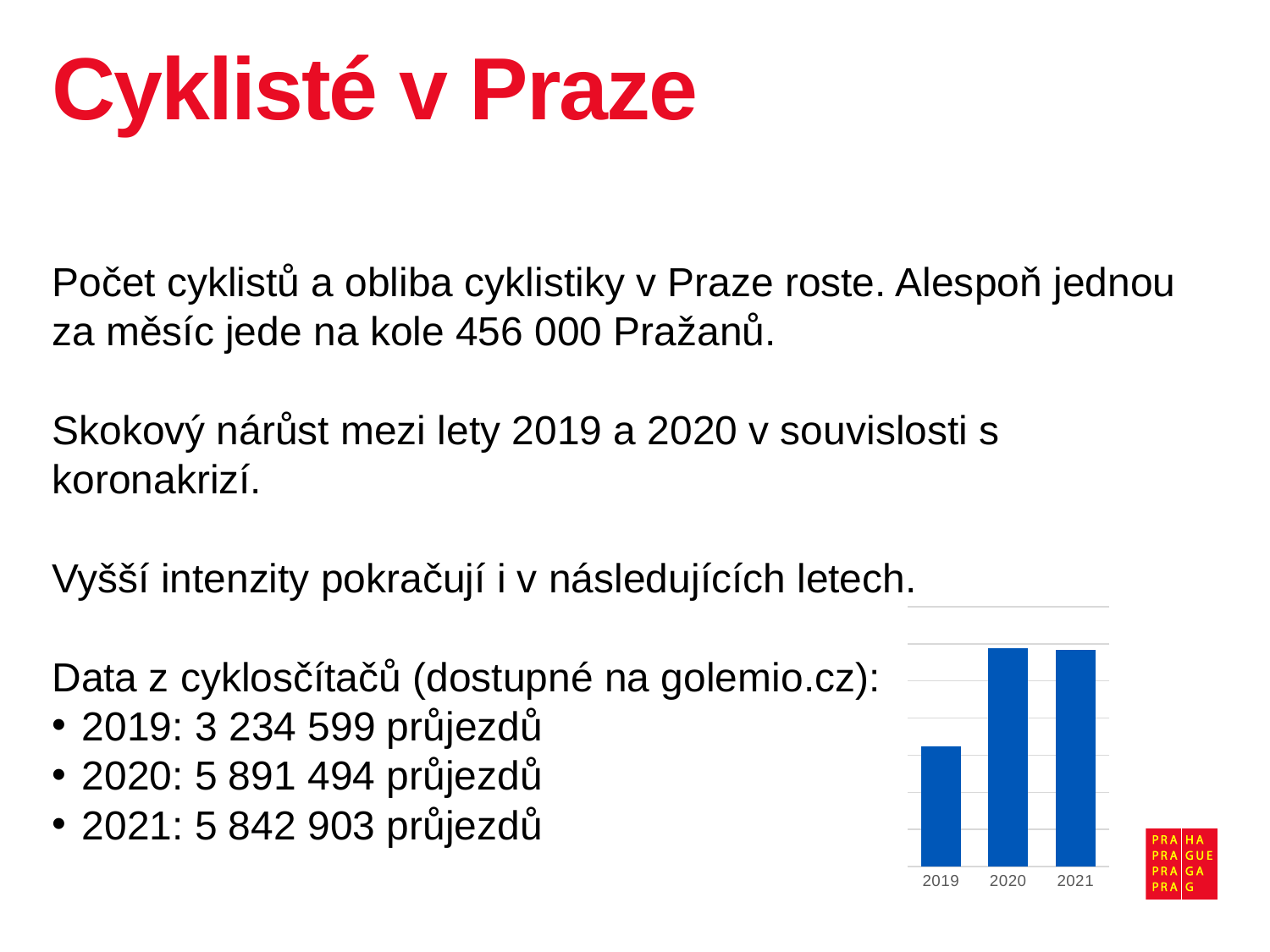
How many průjezdů were recorded in 2021? 5 842 903 What is the difference between the 2020 and 2019 values? 2 656 895 How many bars (years) does the chart show? 3 How many průjezdů were recorded in 2019? 3 234 599 How many průjezdů were recorded in 2020? 5 891 494 How do the values change from 2019 to 2021 along the x axis? rise sharply from 2019 to 2020, then fall slightly in 2021 What kind of chart is shown on the slide? bar chart Is the value for 2020 larger or smaller than the value for 2019? larger What is the difference between the 2020 and 2021 values? 48 591 Which year has the lowest bar in the chart? 2019 Which year has the highest number of průjezdů according to the slide? 2020 What colour are the bars in the chart? blue